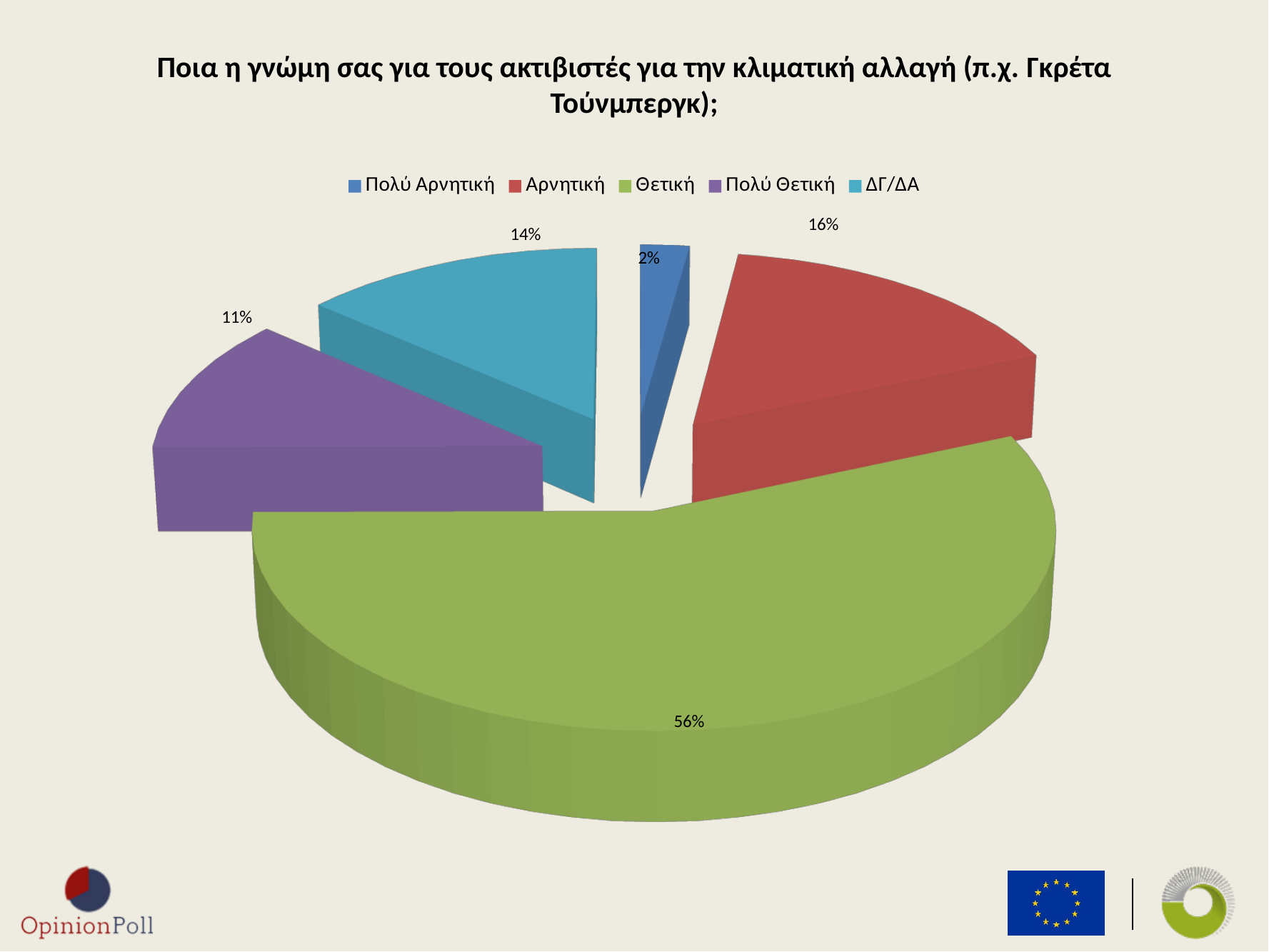
Which is larger, ΔΓ/ΔΑ or Πολύ Θετική? ΔΓ/ΔΑ What kind of chart is shown on the slide? Pie chart What is the value for Πολύ Αρνητική? 2% Which category has the smallest slice? Πολύ Αρνητική What colour is the Θετική slice? Green What is the value for Πολύ Θετική? 11% What is the value for Αρνητική? 16% Which category has the largest slice? Θετική How many categories does the pie chart show? 5 What is the difference between Αρνητική and Πολύ Θετική? 5% What is the value for ΔΓ/ΔΑ? 14% What share of the pie does Θετική have? 56%